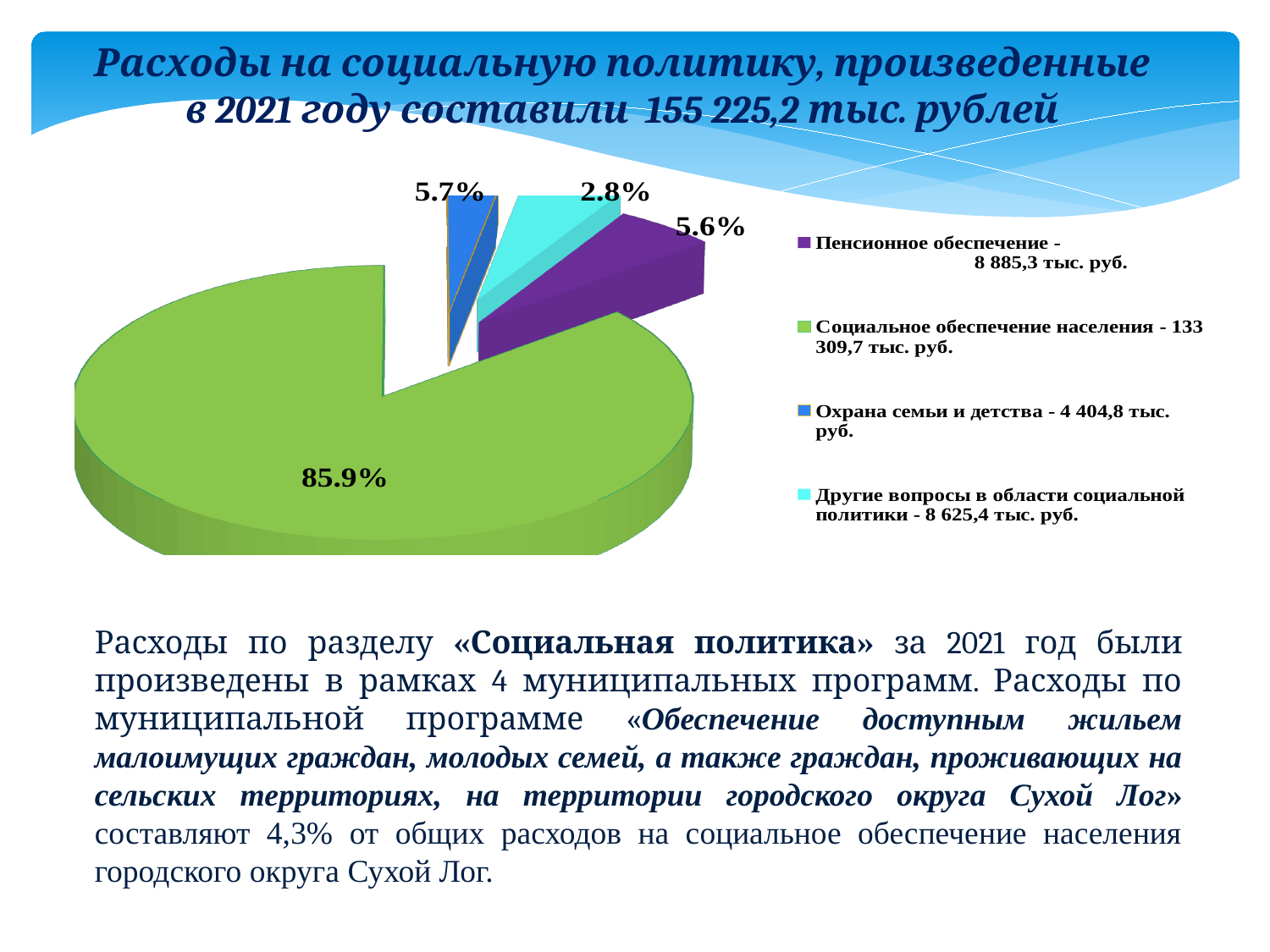
According to the legend, what is the amount for Пенсионное обеспечение? 8 885,3 тыс. руб. What is the smallest percentage label shown on the pie chart? 2.8% What is the difference between the amounts for Пенсионное обеспечение and Другие вопросы в области социальной политики shown in the legend? 259,9 тыс. руб. Which category has the largest slice in the pie chart? Социальное обеспечение населения How many categories does the pie chart's legend list? 4 According to the legend, what is the amount for Охрана семьи и детства? 4 404,8 тыс. руб. What share of the pie does the largest slice (Социальное обеспечение населения) represent? 85.9% What kind of chart is shown on the slide? pie chart According to the legend, what is the amount for Социальное обеспечение населения? 133 309,7 тыс. руб. Which category has the smallest amount according to the legend? Охрана семьи и детства Which is larger according to the legend: Пенсионное обеспечение or Другие вопросы в области социальной политики? Пенсионное обеспечение According to the legend, what is the amount for Другие вопросы в области социальной политики? 8 625,4 тыс. руб.